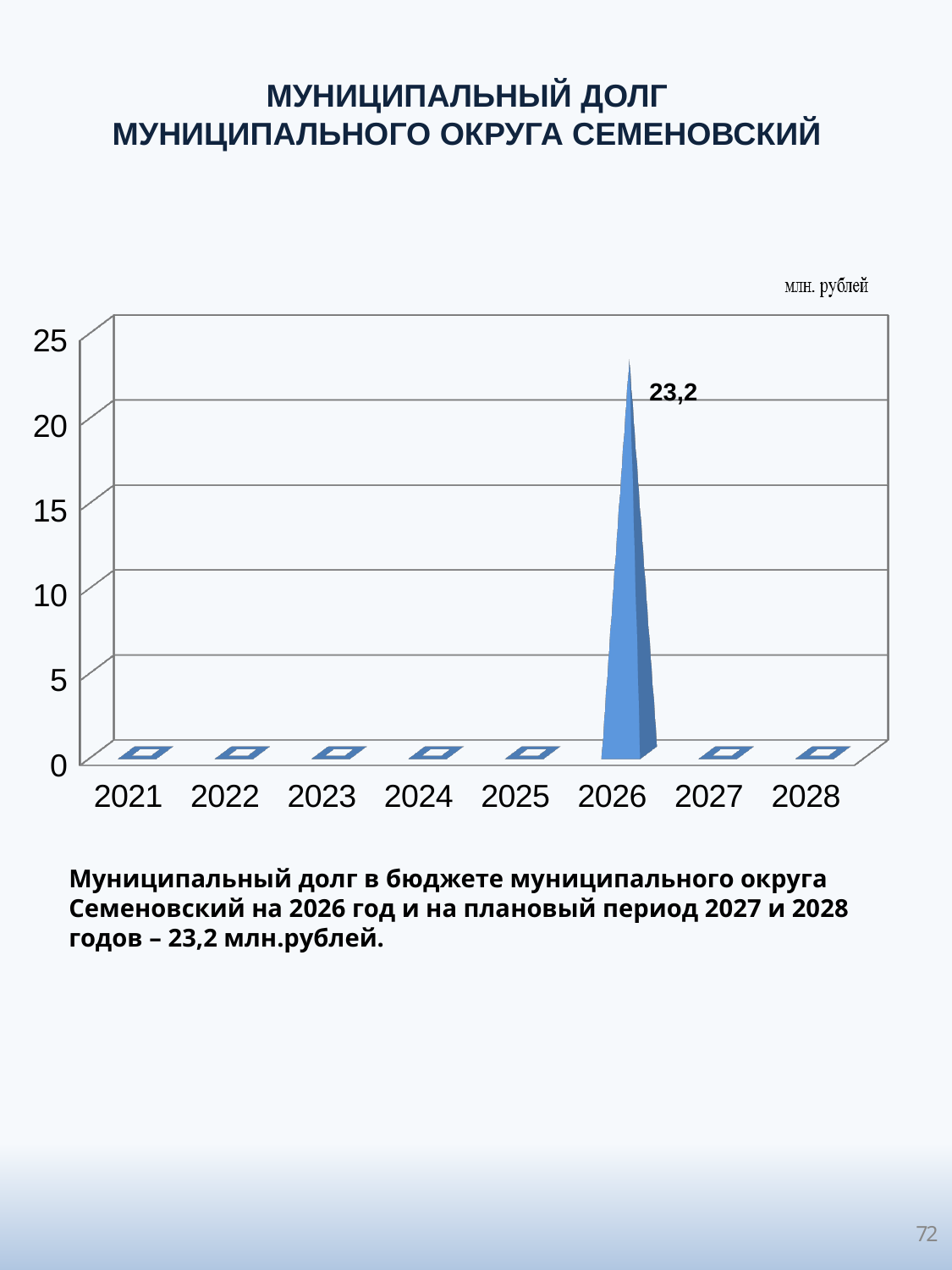
What kind of chart is shown on the slide? bar chart Which year has the highest value on the chart? 2026 Do the values rise or fall from 2026 to 2027? fall How many years are shown on the x axis? 8 What value does the bar for 2024 land on? 0 Is the value for 2026 greater or less than 25? less What unit of measurement is indicated above the chart? млн. рублей What is the highest tick value shown on the vertical axis? 25 What is the title of the slide? МУНИЦИПАЛЬНЫЙ ДОЛГ МУНИЦИПАЛЬНОГО ОКРУГА СЕМЕНОВСКИЙ Which is larger, the value for 2025 or the value for 2026? 2026 Is the value for 2026 greater or less than 20? greater What is the value shown for 2026? 23,2